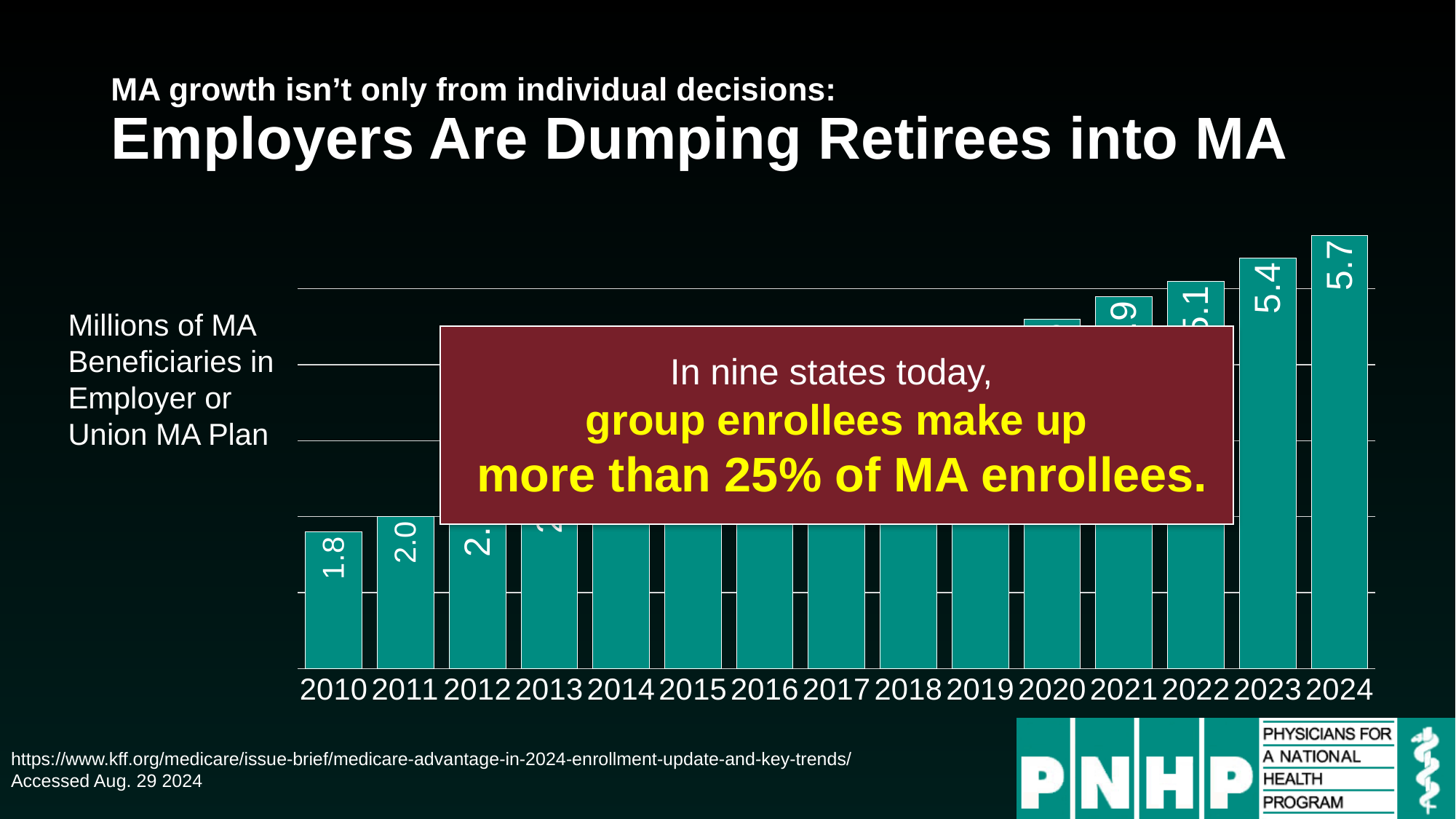
What is the value for 2024? 5.7 Which year has the highest value? 2024 What is the value for 2023? 5.4 What is the value for 2010? 1.8 What is the difference between the values for 2024 and 2010? 3.9 Do the values rise or fall from 2010 to 2024? rise What is the difference between the values for 2024 and 2023? 0.3 What is the value for 2011? 2.0 What type of chart is shown on the slide? bar chart Which is larger, the value for 2011 or the value for 2010? 2011 Which year has the lowest value? 2010 How many years are shown on the x axis? 15